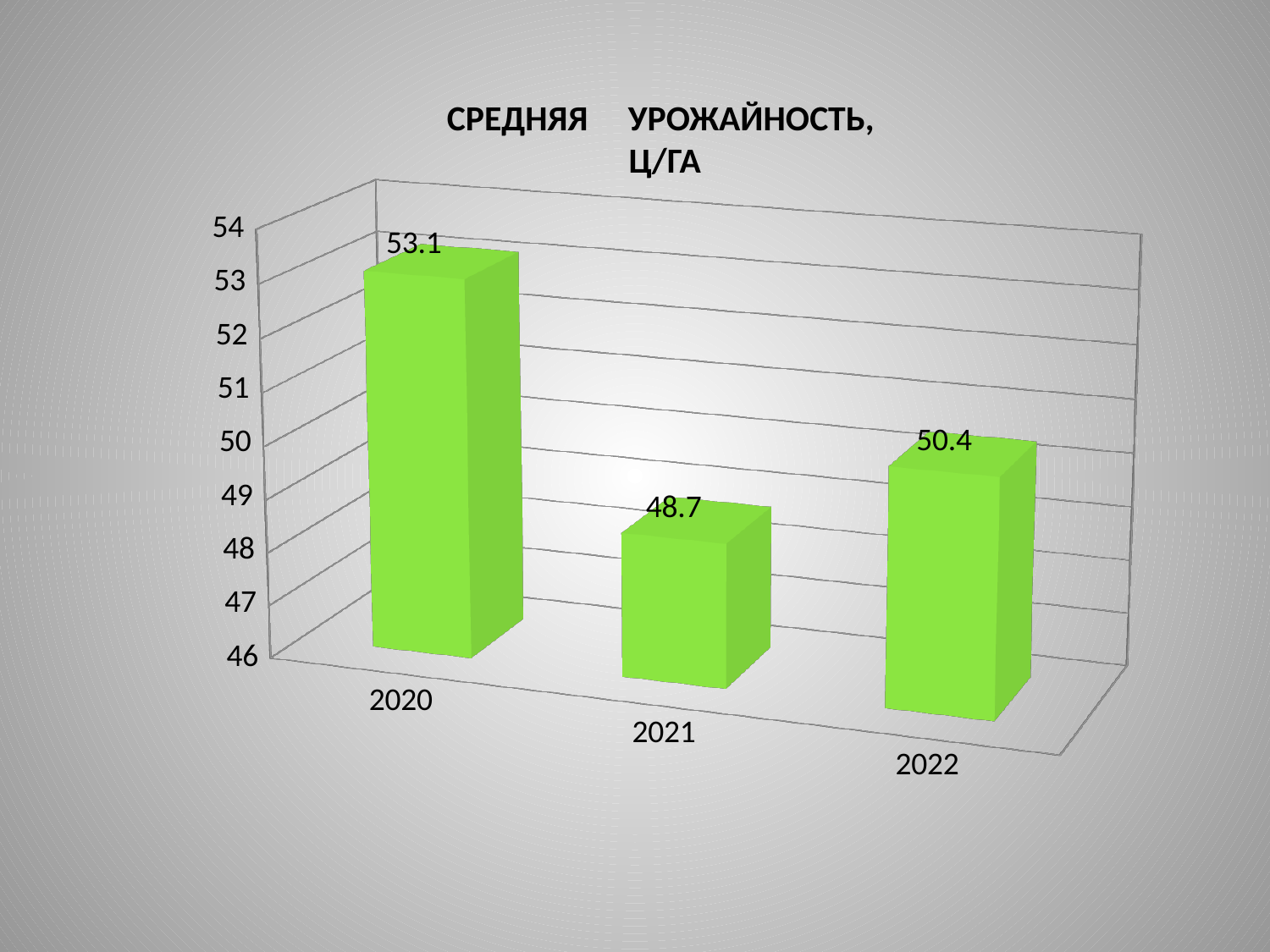
What is the difference between the 2020 and 2021 values? 4.4 Which year has the highest average yield? 2020 What is the average yield value shown for 2021? 48.7 What is the average yield value shown for 2022? 50.4 Which is larger, the value for 2020 or the value for 2022? 2020 Which year has the lowest average yield? 2021 What kind of chart is shown on the slide? bar chart How many years are shown on the chart? 3 What is the difference between the 2022 and 2021 values? 1.7 Is the value for 2021 greater or less than 50? less What is the title of the chart? СРЕДНЯЯ УРОЖАЙНОСТЬ, Ц/ГА What is the average yield value shown for 2020? 53.1